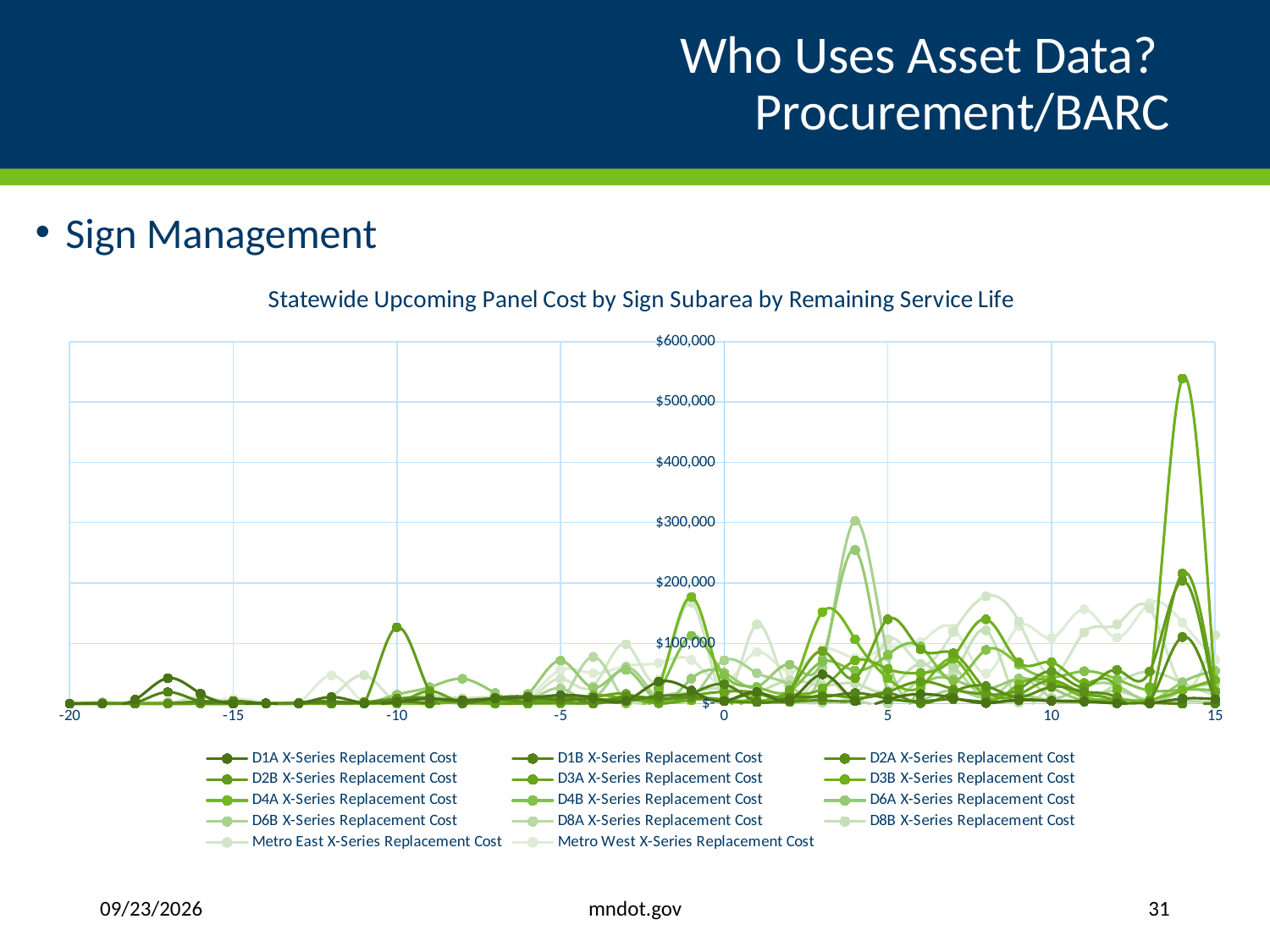
Is the highest peak plotted on the chart greater or less than $500,000? greater What is the highest value labelled on the horizontal axis? 15 What kind of chart is shown on the slide? line chart What is the highest value labelled on the vertical axis? $600,000 Is the highest peak plotted on the chart greater or less than $600,000? less What is the title of the chart? Statewide Upcoming Panel Cost by Sign Subarea by Remaining Service Life Is the tallest peak near x = -10 greater or less than $200,000? less How many series does the legend list? 14 Near which horizontal-axis value does the highest peak on the chart occur: 14 or -10? 14 What is the lowest value labelled on the horizontal axis? -20